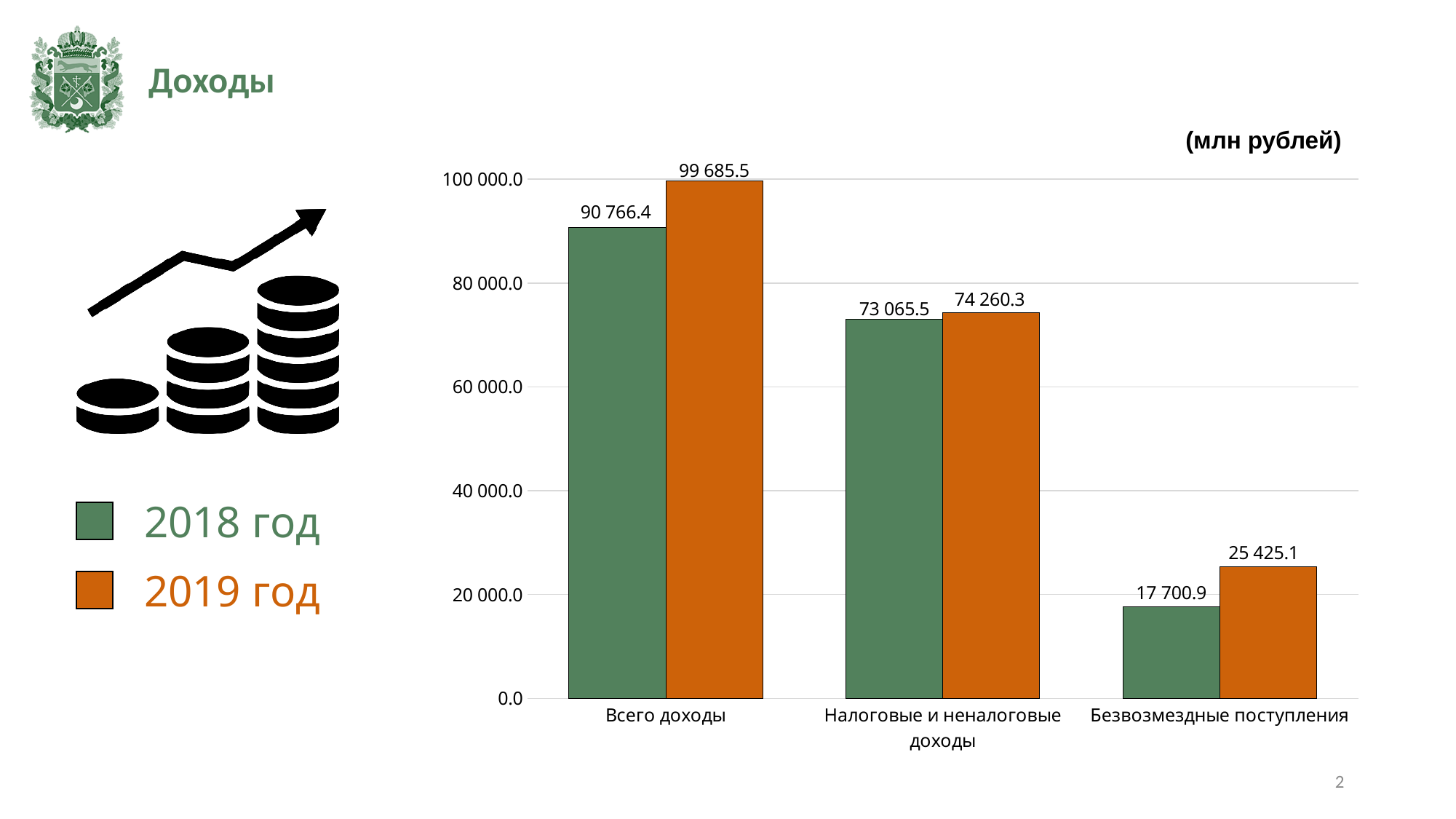
Which category has the highest value in 2019 год? Всего доходы Is the 2018 год value for Безвозмездные поступления greater or less than 20 000.0? less What is the difference between the 2019 год and 2018 год values for Всего доходы? 8 919.1 Which category has the lowest value in 2018 год? Безвозмездные поступления Which is larger for Налоговые и неналоговые доходы: the 2018 год value or the 2019 год value? 2019 год How many categories are shown on the x axis of the chart? 3 What is the value for Безвозмездные поступления in 2019 год? 25 425.1 What type of chart is shown on the slide? bar chart How many series does the legend list? 2 What is the value for Всего доходы in 2018 год? 90 766.4 What is the value for Налоговые и неналоговые доходы in 2019 год? 74 260.3 What is the difference between the 2019 год and 2018 год values for Безвозмездные поступления? 7 724.2